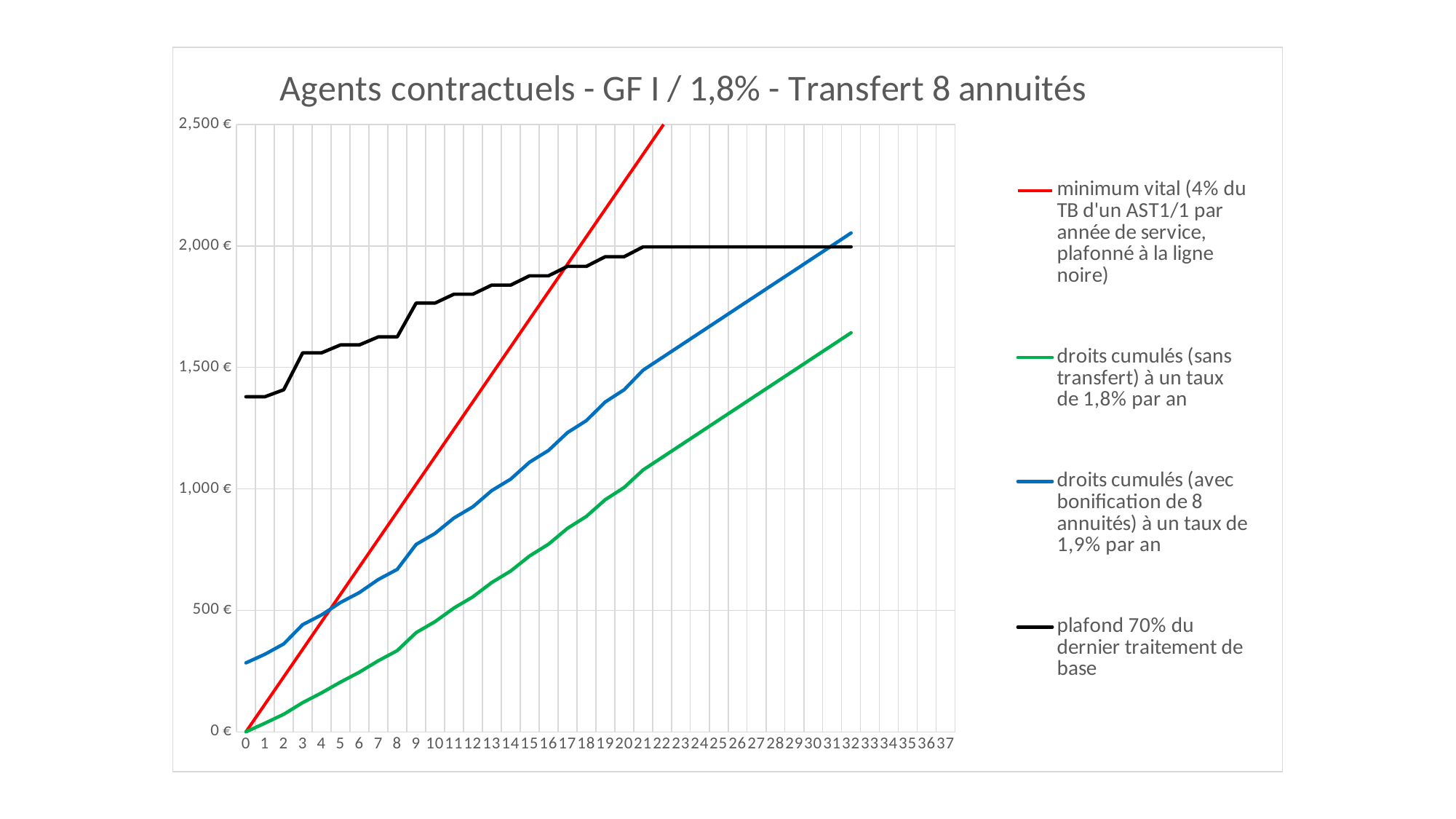
What is the title of the chart? Agents contractuels - GF I / 1,8% - Transfert 8 annuités Does the green series 'droits cumulés (sans transfert) à un taux de 1,8% par an' rise or fall along the x axis? rise Is the value of the green series 'droits cumulés (sans transfert)' at x = 32 greater or less than 1,500 €? greater Is the value of the green series 'droits cumulés (sans transfert)' at x = 10 greater or less than 500 €? less How many series does the legend list? 4 Which colour is used for the series 'plafond 70% du dernier traitement de base'? black Is the value of the blue series 'droits cumulés (avec bonification de 8 annuités)' at x = 20 greater or less than 1,500 €? less What kind of chart is shown on the slide? line chart At x = 10, which is larger: the red 'minimum vital' series or the blue 'droits cumulés (avec bonification de 8 annuités)' series? minimum vital (red) At x = 0, which is larger: the black 'plafond 70% du dernier traitement de base' series or the blue 'droits cumulés (avec bonification de 8 annuités)' series? plafond 70% du dernier traitement de base (black)